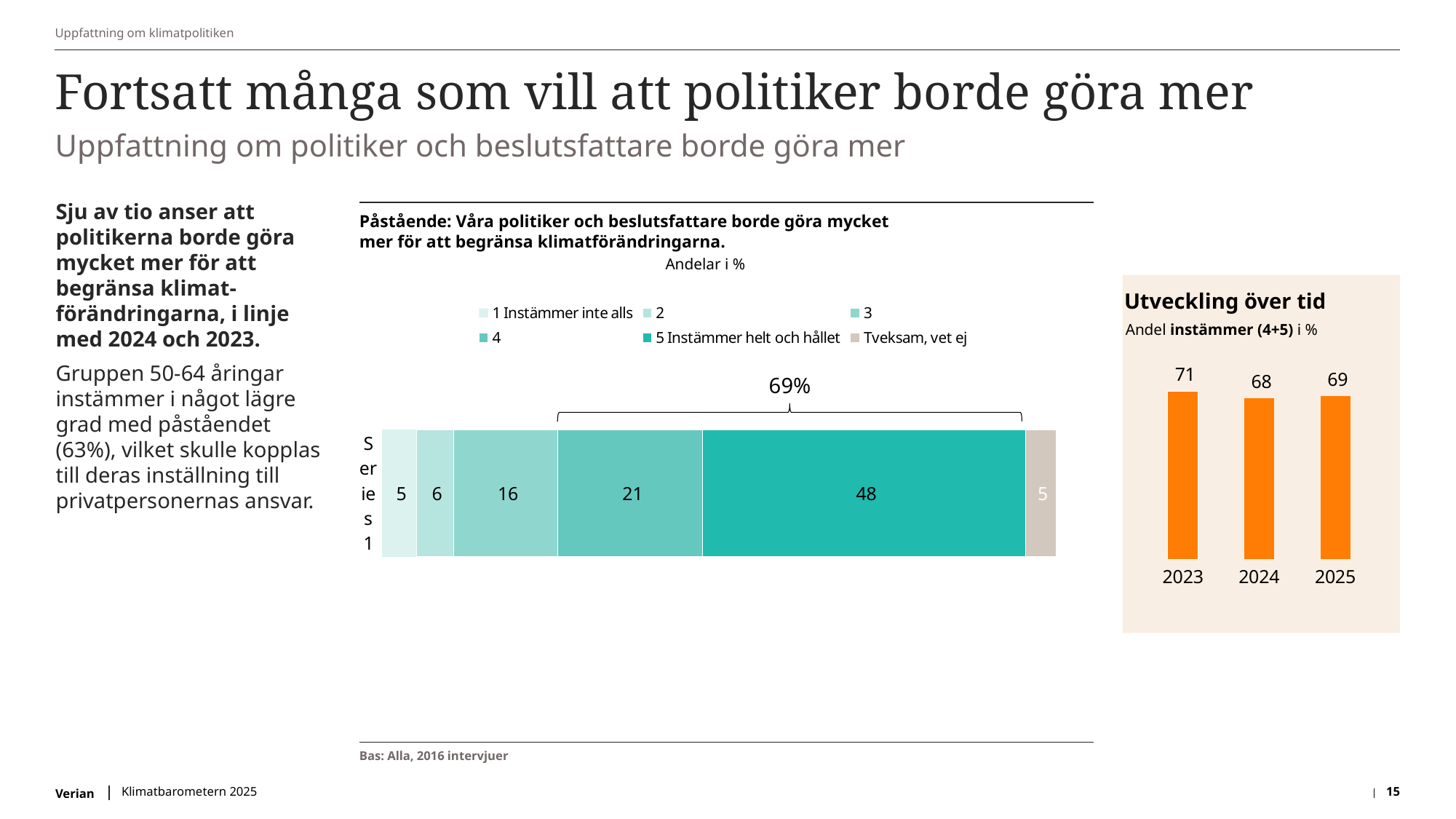
In the stacked bar chart on the left, what is the value for '5 Instämmer helt och hållet'? 48 In the stacked bar chart on the left, what is the difference between the values for '5 Instämmer helt och hållet' and '4'? 27 In the 'Utveckling över tid' chart, what is the value for 2023? 71 What kind of chart is the 'Utveckling över tid' chart? bar chart In the 'Utveckling över tid' chart, how many years are shown? 3 In the stacked bar chart on the left, how many series does the legend list? 6 In the 'Utveckling över tid' chart, which year has the lowest value? 2024 In the stacked bar chart on the left, what is the value for '1 Instämmer inte alls'? 5 In the 'Utveckling över tid' chart, what is the difference between the values for 2023 and 2025? 2 In the stacked bar chart on the left, what is the value for category '3'? 16 In the stacked bar chart on the left, what percentage is shown above the bracket spanning categories 4 and 5? 69% In the stacked bar chart on the left, which legend category has the largest value? 5 Instämmer helt och hållet